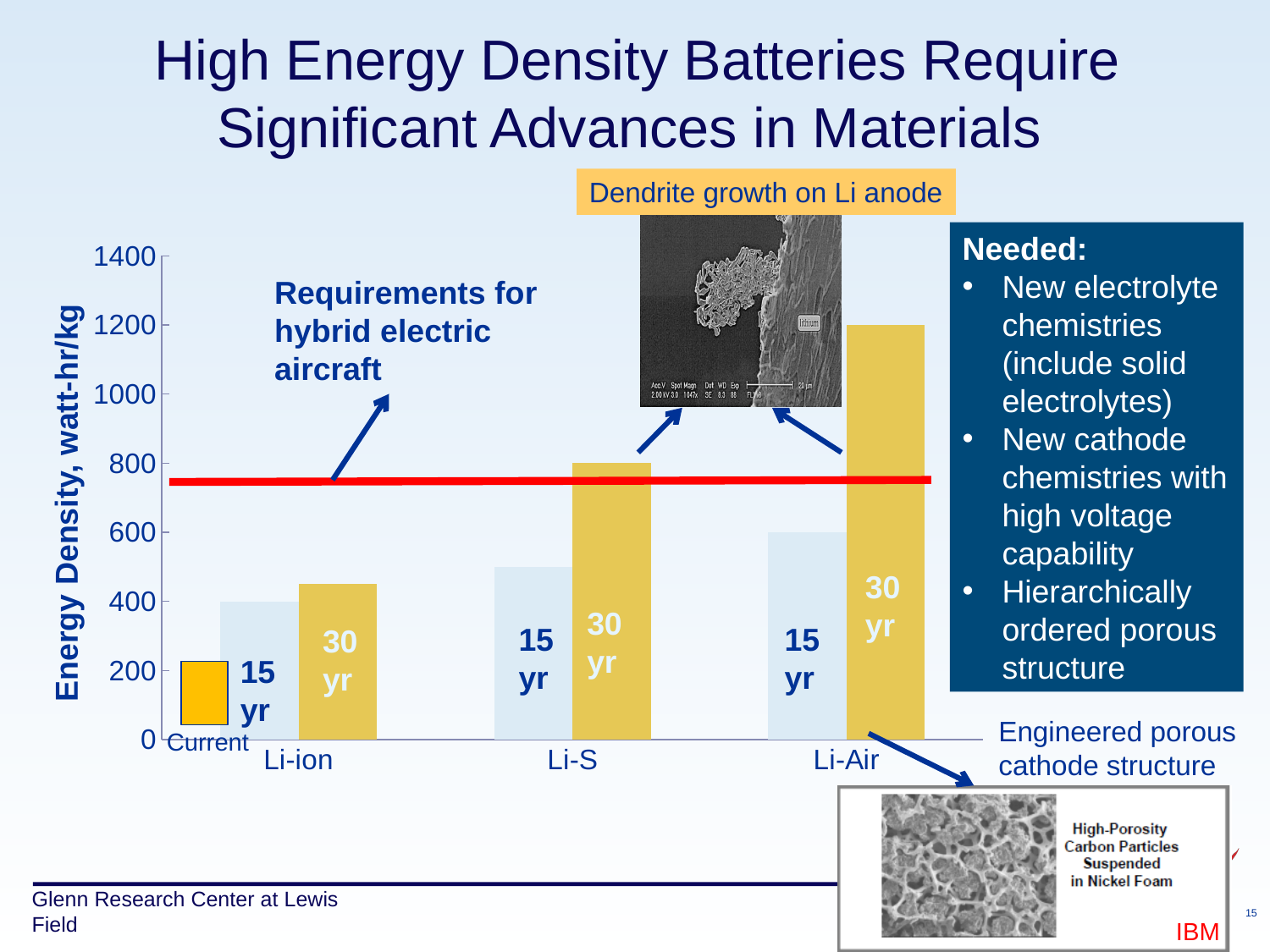
Which is larger, the Li-S 30 yr bar or the Li-Air 15 yr bar? Li-S 30 yr Which bar in the chart is the lowest? Current Is the value for the Li-ion 30 yr bar greater or less than 600? less What does the red horizontal line across the chart represent? Requirements for hybrid electric aircraft What type of chart is shown on the slide? bar chart What is the energy density shown for the Li-Air 30 yr bar? 1200 How many battery categories are labelled along the x axis of the chart? 4 What is the energy density shown for the Li-ion 15 yr bar? 400 Is the value for the Li-S 15 yr bar greater or less than 400? greater Which bar in the chart is the highest? Li-Air 30 yr What is the energy density shown for the Li-S 30 yr bar? 800 What is the y-axis label of the chart? Energy Density, watt-hr/kg